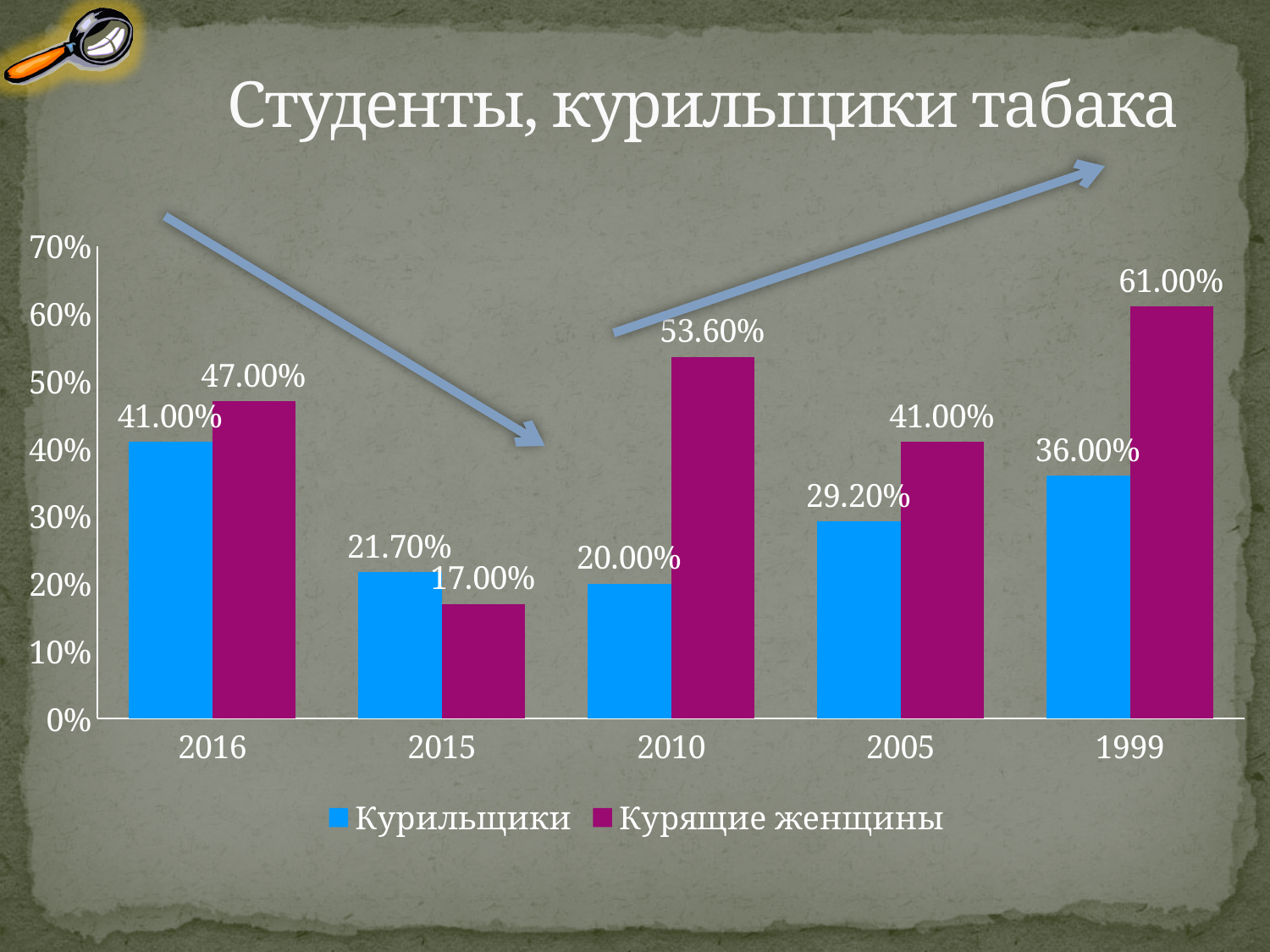
What kind of chart is shown on the slide? bar chart What colour are the bars for Курящие женщины? purple What is the value for Курящие женщины in 2010? 53.60% How many series does the legend list? 2 What is the value for Курильщики in 2005? 29.20% How many years are shown on the x axis? 5 Which year has the lowest value for Курильщики? 2010 Which is larger in 2015: Курильщики or Курящие женщины? Курильщики What is the title of the slide? Студенты, курильщики табака Which year has the highest value for Курящие женщины? 1999 What is the value for Курильщики in 2016? 41.00% What is the difference between Курящие женщины and Курильщики in 2010? 33.60%